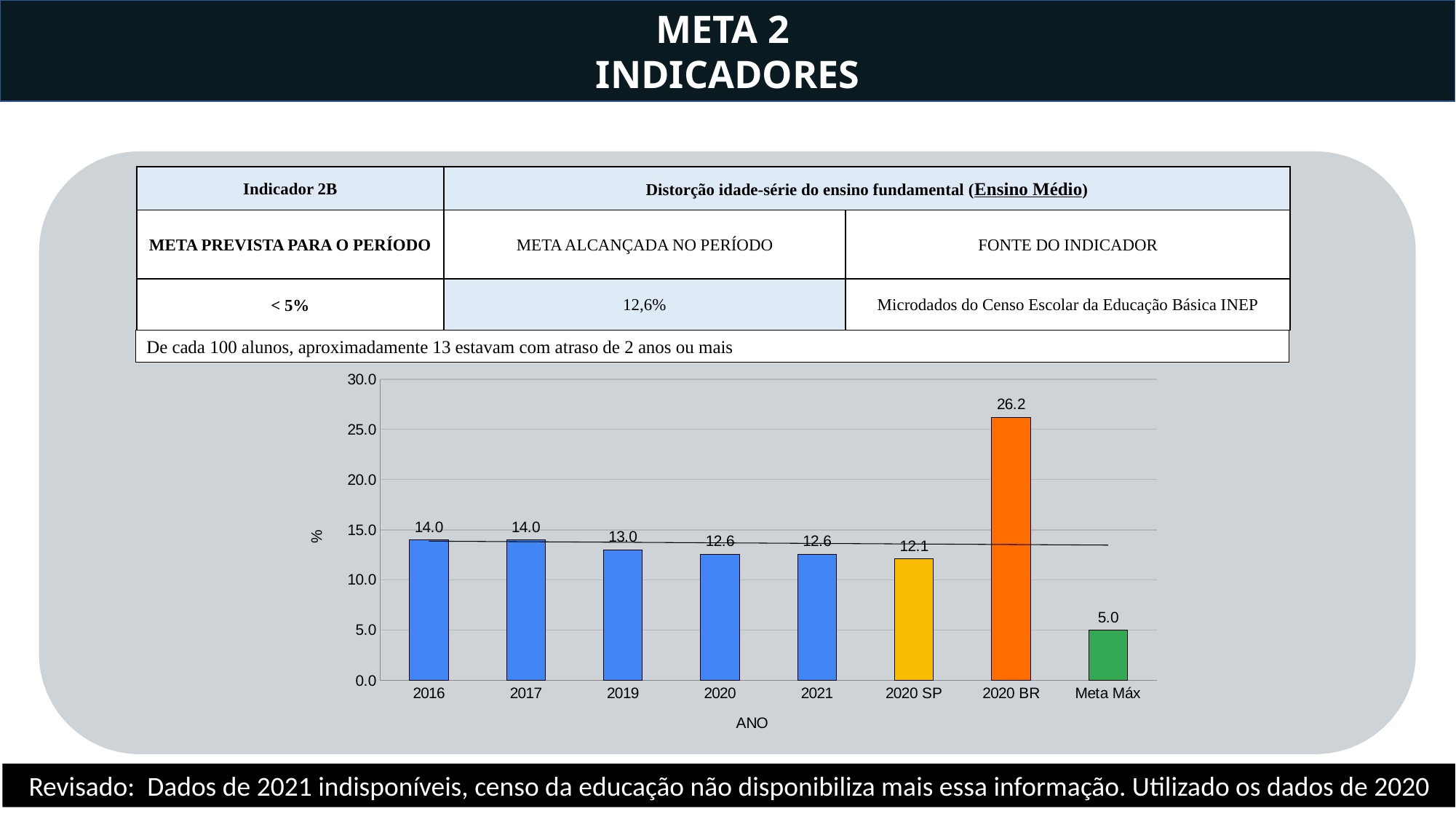
What is the value for 2020 BR in the chart? 26.2 Which category has the lowest value in the chart? Meta Máx What is the difference between the values for 2020 BR and 2020 SP? 14.1 Which category has the highest value in the chart? 2020 BR Is the value for 2020 BR greater or less than 25.0? greater What is the value for Meta Máx in the chart? 5.0 What kind of chart is shown on the slide? bar chart What is the label of the x axis of the chart? ANO How many categories are shown on the x axis of the chart? 8 What is the value for 2016 in the chart? 14.0 Which is larger, the value for 2019 or the value for 2021? 2019 What is the value for 2020 SP in the chart? 12.1